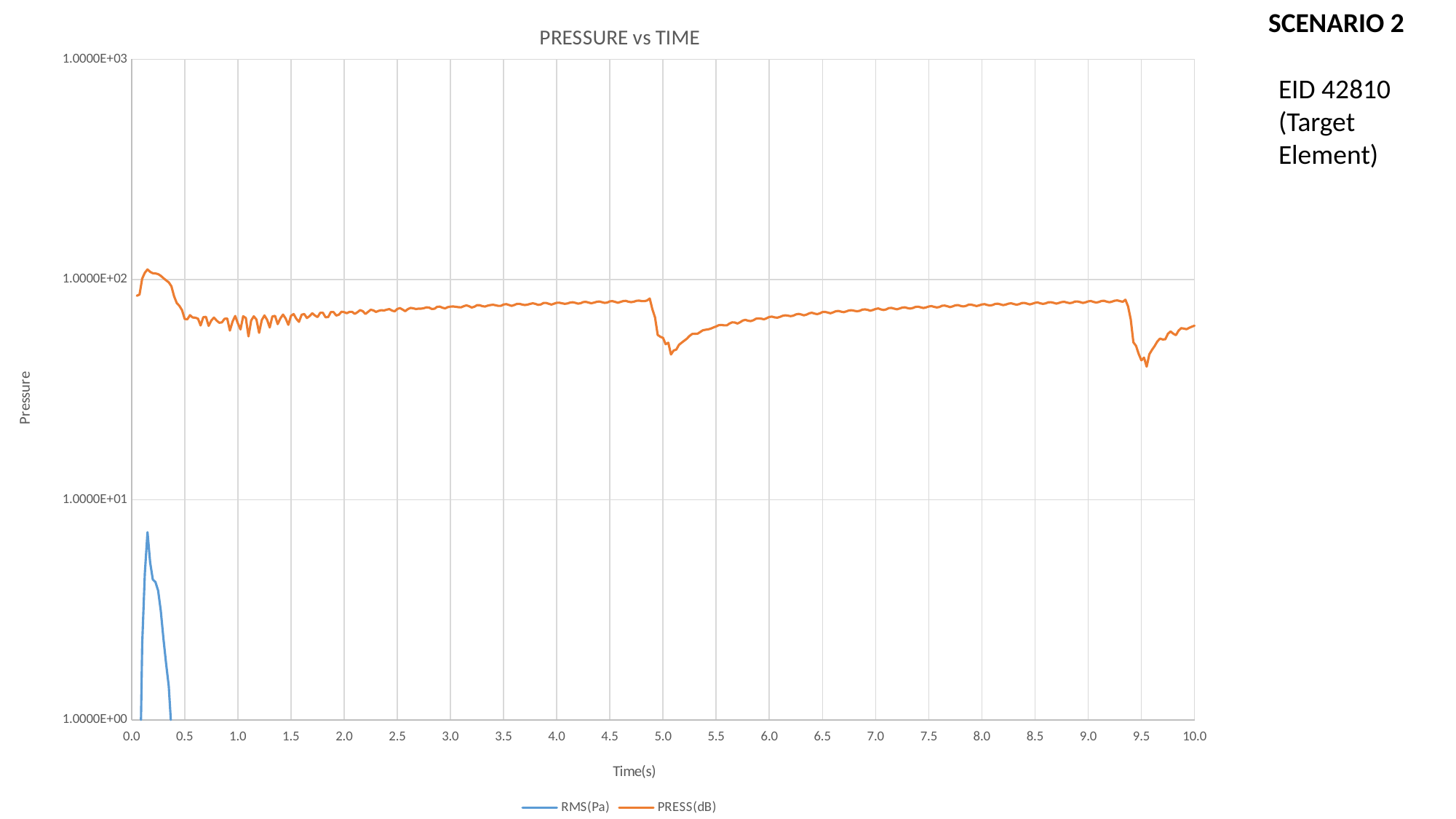
Which series reaches the highest value on the chart? PRESS(dB) Does the PRESS(dB) line rise or fall between time 5.5 and time 9.0? rise Is the value of PRESS(dB) at time 3.0 greater or less than 1.0000E+02? less How many labelled tick marks are on the Time(s) axis? 21 Which series is drawn in orange? PRESS(dB) Is the value of PRESS(dB) at time 0.2 greater or less than 1.0000E+02? greater At time 0.2, which series has the higher value, RMS(Pa) or PRESS(dB)? PRESS(dB) Is the value of PRESS(dB) at time 3.0 greater or less than 1.0000E+01? greater What kind of chart is shown on the slide? line chart What is the title of the chart? PRESSURE vs TIME How many series does the legend list? 2